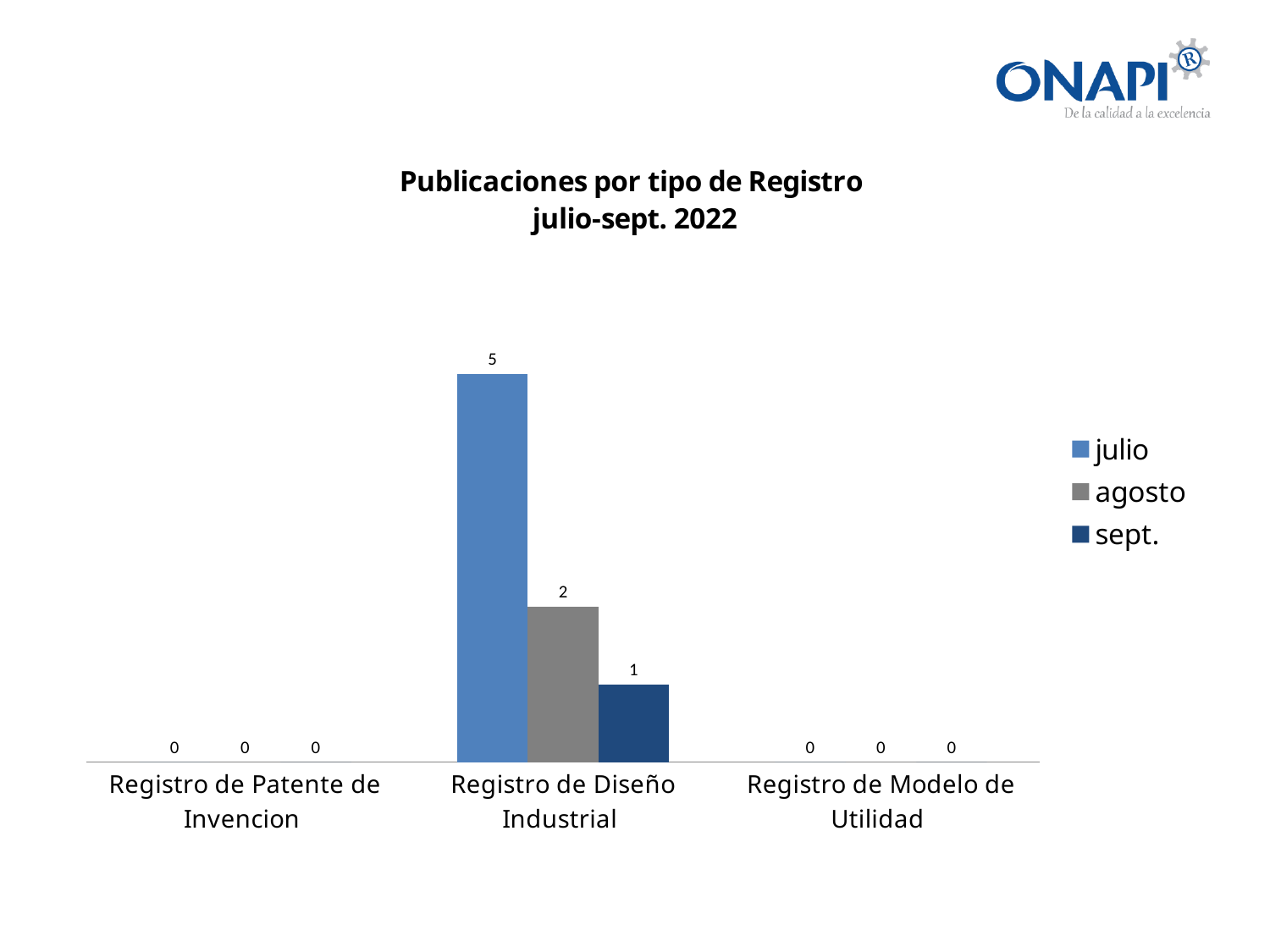
Which category has the highest value for julio? Registro de Diseño Industrial What kind of chart is shown on the slide? Bar chart What is the difference between the agosto and sept. values for Registro de Diseño Industrial? 1 What is the value for agosto in the Registro de Modelo de Utilidad category? 0 Which is larger for Registro de Diseño Industrial, the julio value or the sept. value? julio What is the value for sept. in the Registro de Diseño Industrial category? 1 How many categories are shown on the x axis? 3 What is the difference between the julio and agosto values for Registro de Diseño Industrial? 3 How many series does the legend list? 3 What is the value for agosto in the Registro de Diseño Industrial category? 2 What is the value for julio in the Registro de Patente de Invencion category? 0 What is the value for julio in the Registro de Diseño Industrial category? 5